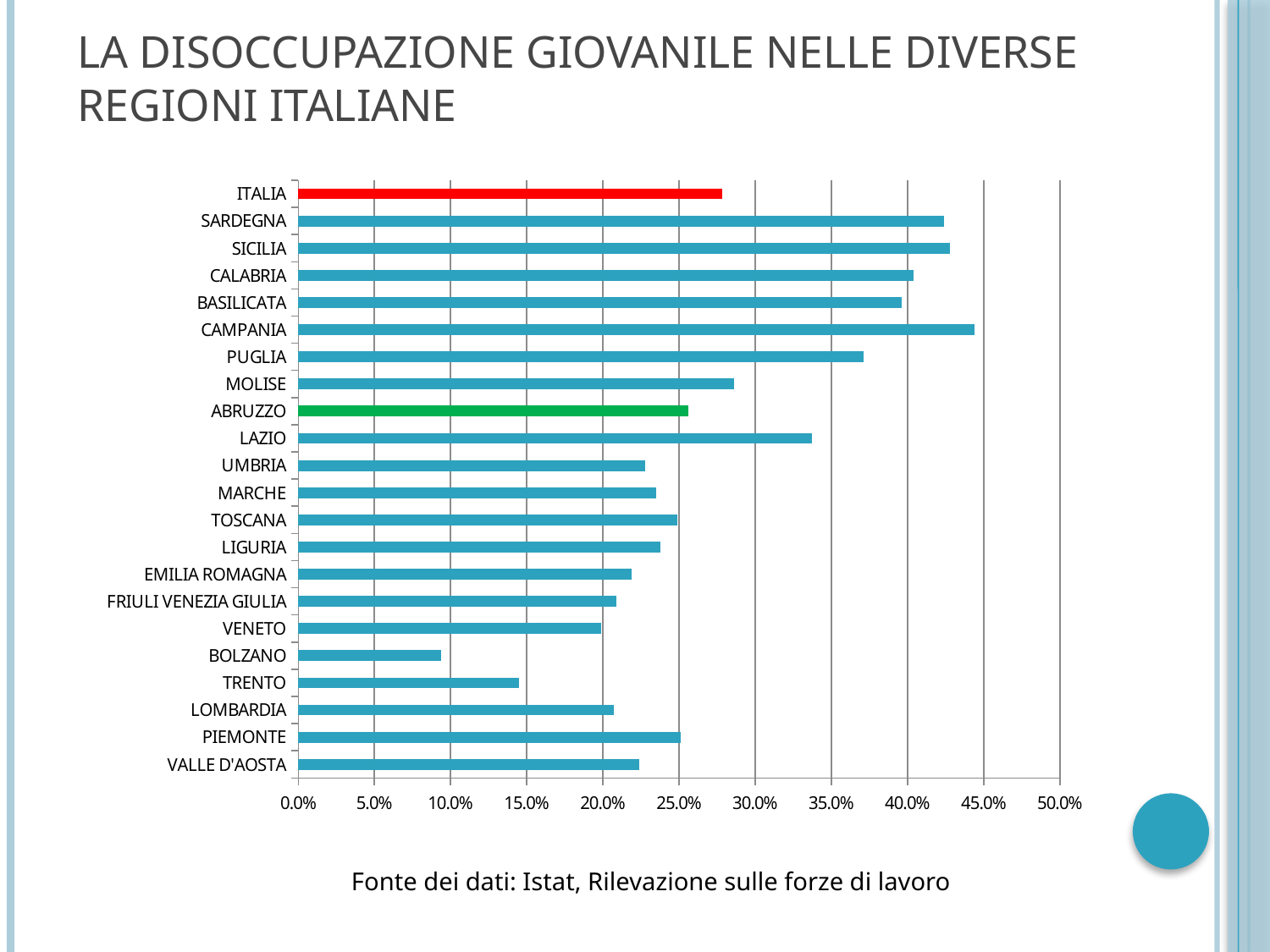
Is the value for CAMPANIA greater or less than 40.0%? greater Is the value for UMBRIA greater or less than 25.0%? less Which category has the highest youth unemployment rate in the chart? CAMPANIA Which category has the lowest youth unemployment rate in the chart? BOLZANO What colour is the bar for ITALIA? red Is the value for ITALIA greater or less than 25.0%? greater How many categories (bars) are plotted in the chart? 22 Which has the larger value, PUGLIA or LAZIO? PUGLIA What kind of chart is shown on the slide? bar chart Which has the larger value, PIEMONTE or LOMBARDIA? PIEMONTE